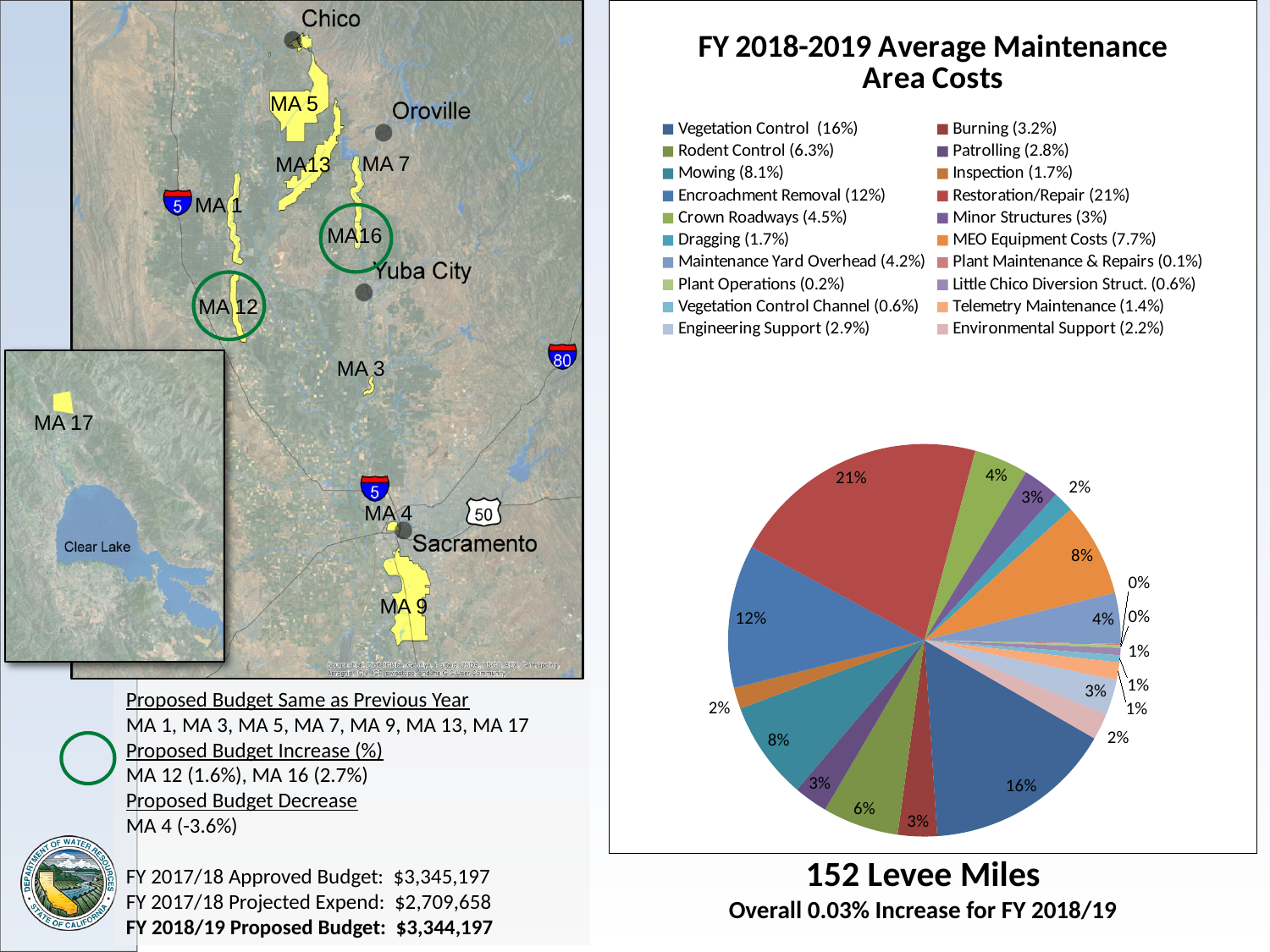
What share of the pie does Restoration/Repair represent? 21% What percentage is shown for Rodent Control in the legend? 6.3% Which category has the largest share of the pie? Restoration/Repair What percentage is shown for MEO Equipment Costs in the legend? 7.7% What kind of chart is shown on the slide? pie chart What is the difference in percentage points between Restoration/Repair (21%) and Vegetation Control (16%)? 5% Which category has the smallest share of the pie? Plant Maintenance & Repairs What percentage is shown for Mowing in the legend? 8.1% How many categories does the chart's legend list? 20 What percentage is shown for Engineering Support in the legend? 2.9% Which is larger, the share for Vegetation Control or the share for Encroachment Removal? Vegetation Control What is the title of the chart? FY 2018-2019 Average Maintenance Area Costs